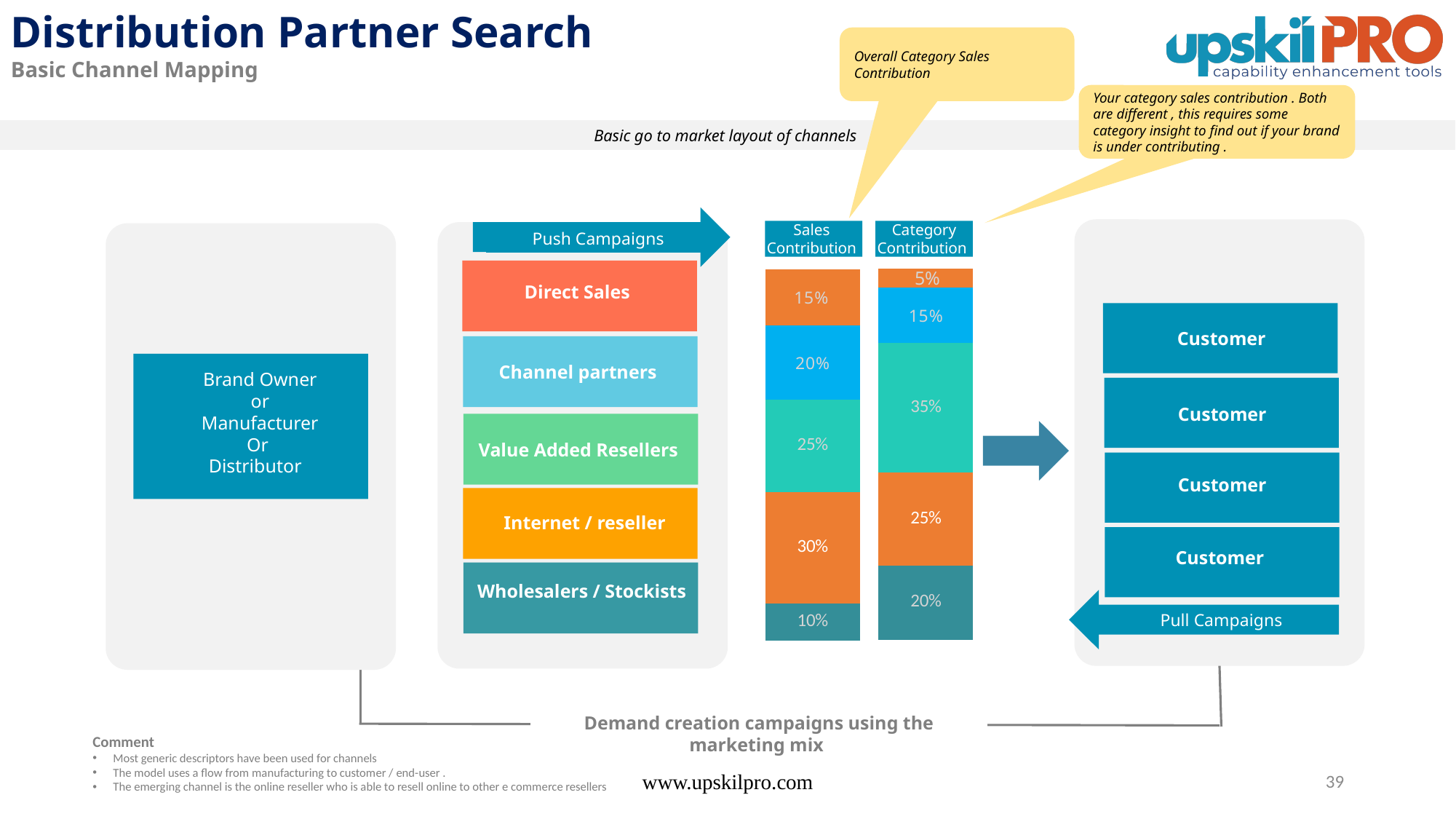
What is the total of all segments in the Category Contribution bar? 100% How many segments does the Sales Contribution bar contain? 5 In the Sales Contribution bar, what is the value of the top segment (aligned with Direct Sales)? 15% What type of chart is used to show Sales Contribution and Category Contribution? Stacked bar chart What is the difference between the Sales Contribution and Category Contribution values for the segment aligned with Direct Sales? 10% For the segment aligned with Wholesalers / Stockists, which bar shows the larger value, Sales Contribution or Category Contribution? Category Contribution Which segment of the Sales Contribution bar has the largest value? 30% (Internet / reseller) In the Sales Contribution bar, what is the value of the bottom segment (aligned with Wholesalers / Stockists)? 10% In the Category Contribution bar, what is the value of the segment aligned with Value Added Resellers? 35% Which segment of the Category Contribution bar has the smallest value? 5% (Direct Sales) What are the titles of the two stacked bars on the slide? Sales Contribution and Category Contribution In the Category Contribution bar, what is the value of the top segment (aligned with Direct Sales)? 5%